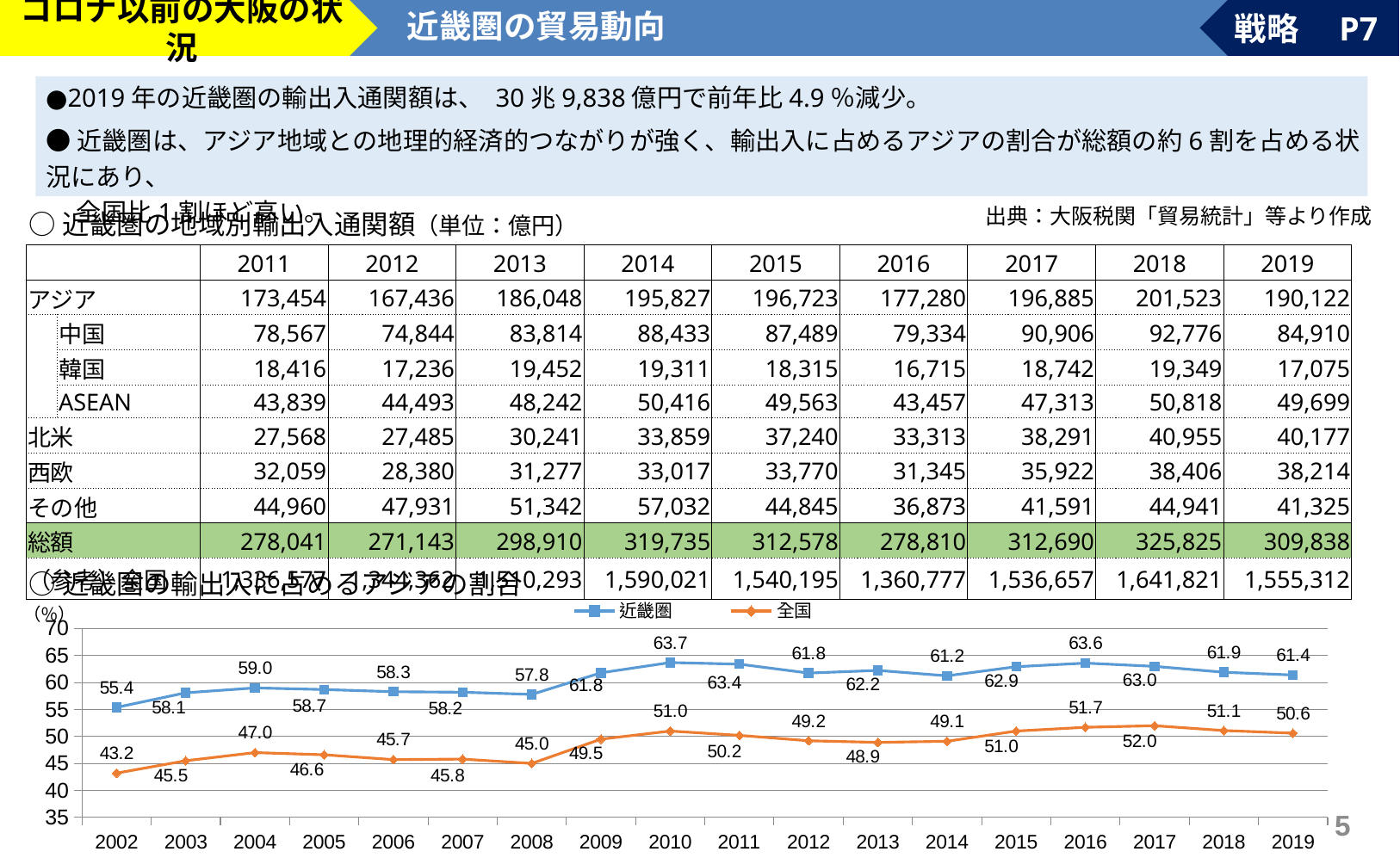
In the chart 近畿圏の輸出入に占めるアジアの割合, in which year is the 近畿圏 value lowest? 2002 In the chart 近畿圏の輸出入に占めるアジアの割合, is the 全国 value in 2002 greater or less than 45? less In the chart 近畿圏の輸出入に占めるアジアの割合, how many series does the legend list? 2 In the chart 近畿圏の輸出入に占めるアジアの割合, how many years are plotted on the x axis? 18 In the chart 近畿圏の輸出入に占めるアジアの割合, what is the value for 近畿圏 in 2002? 55.4 What kind of chart is 近畿圏の輸出入に占めるアジアの割合? line chart In the chart 近畿圏の輸出入に占めるアジアの割合, which is larger: the 近畿圏 value in 2010 or in 2009? 2010 In the chart 近畿圏の輸出入に占めるアジアの割合, what is the difference between the 近畿圏 and 全国 values in 2019? 10.8 In the chart 近畿圏の輸出入に占めるアジアの割合, what is the value for 全国 in 2019? 50.6 In the chart 近畿圏の輸出入に占めるアジアの割合, in which year is the 全国 value lowest? 2002 In the chart 近畿圏の輸出入に占めるアジアの割合, does the 全国 value rise or fall from 2008 to 2010? rise In the chart 近畿圏の輸出入に占めるアジアの割合, what is the value for 近畿圏 in 2010? 63.7